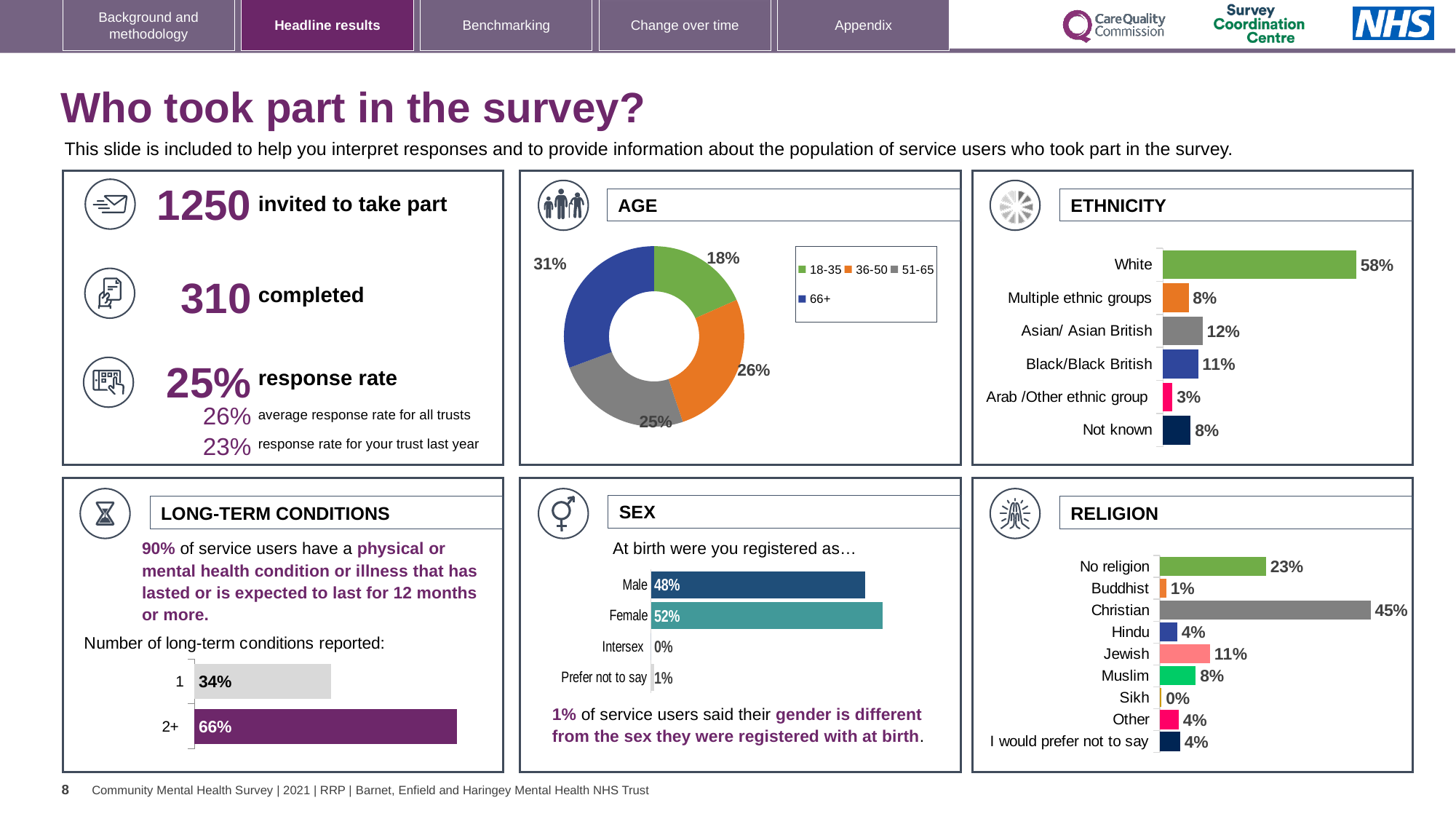
In the AGE chart, which age group has the smallest share? 18-35 In the ETHNICITY chart, which category has the highest value? White In the RELIGION chart, what is the value for Jewish? 11% How many categories are shown in the ETHNICITY chart? 6 In the LONG-TERM CONDITIONS chart, what percentage reported 2+ conditions? 66% What kind of chart is the AGE chart? Donut (pie) chart In the ETHNICITY chart, what is the value for Asian/ Asian British? 12% In the ETHNICITY chart, what is the difference between White and Black/Black British? 47% How many age groups does the legend of the AGE chart list? 4 In the SEX chart, which is larger, Male or Female? Female In the AGE chart, what percentage of respondents were aged 66+? 31% In the RELIGION chart, which category has the highest value? Christian